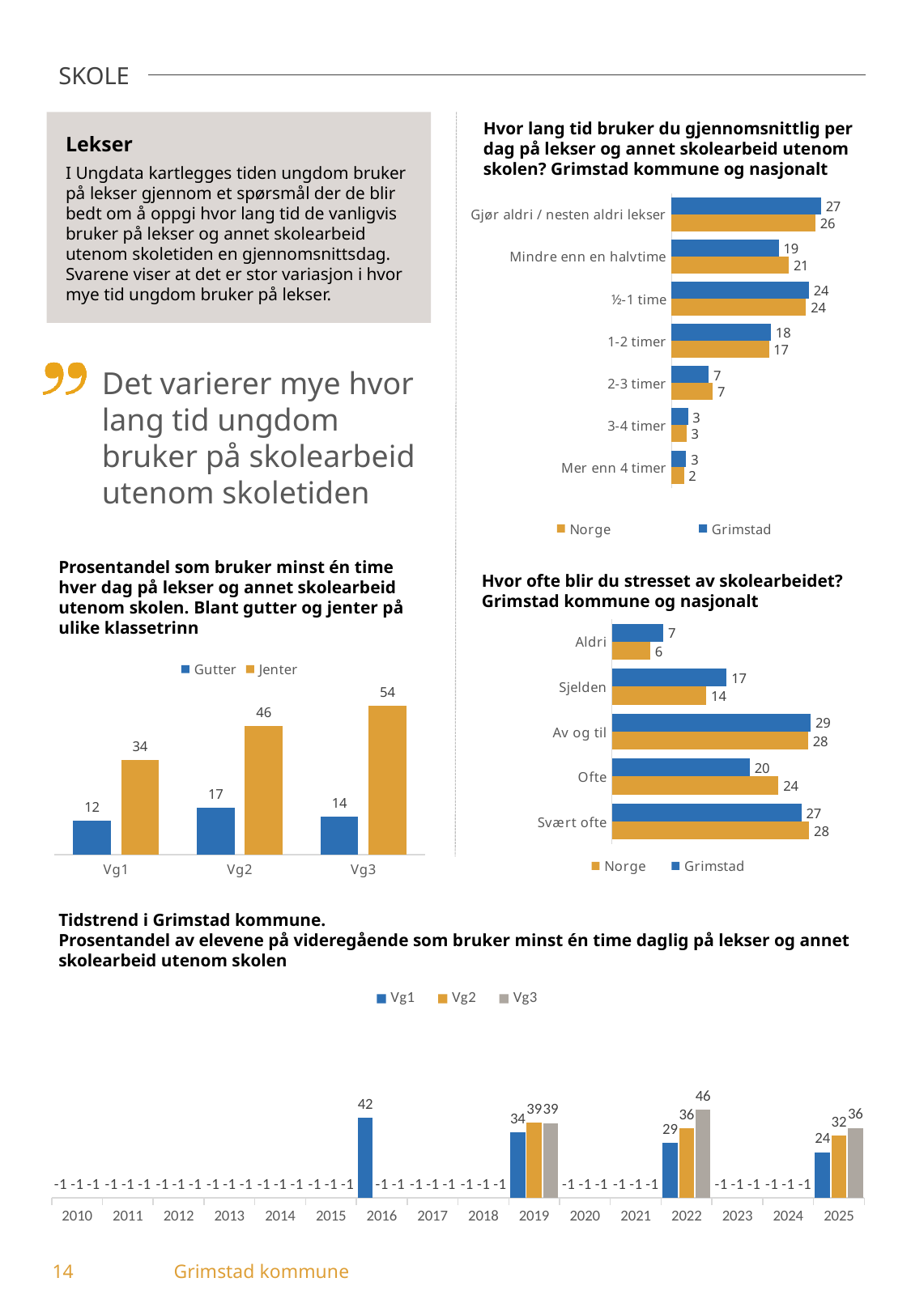
In the chart 'Hvor lang tid bruker du gjennomsnittlig per dag på lekser og annet skolearbeid utenom skolen?', how many categories are shown? 7 In the chart 'Tidstrend i Grimstad kommune', does the Vg1 value rise or fall from 2016 to 2025? fall In the chart 'Prosentandel som bruker minst én time hver dag på lekser og annet skolearbeid utenom skolen', which class level has the lowest value for Gutter? Vg1 In the chart 'Prosentandel som bruker minst én time hver dag på lekser og annet skolearbeid utenom skolen', what is the value for Jenter at Vg3? 54 In the chart 'Hvor ofte blir du stresset av skolearbeidet?', how many series does the legend list? 2 What kind of chart is 'Tidstrend i Grimstad kommune'? bar chart In the chart 'Prosentandel som bruker minst én time hver dag på lekser og annet skolearbeid utenom skolen', what is the difference between Jenter and Gutter at Vg2? 29 In the chart 'Hvor lang tid bruker du gjennomsnittlig per dag på lekser og annet skolearbeid utenom skolen?', what is the Grimstad value for 'Mindre enn en halvtime'? 19 In the chart 'Hvor ofte blir du stresset av skolearbeidet?', what is the Norge value for 'Ofte'? 24 In the chart 'Hvor lang tid bruker du gjennomsnittlig per dag på lekser og annet skolearbeid utenom skolen?', which category has the highest Grimstad value? Gjør aldri / nesten aldri lekser In the chart 'Hvor ofte blir du stresset av skolearbeidet?', which is larger for 'Sjelden': Grimstad or Norge? Grimstad In the chart 'Tidstrend i Grimstad kommune', what is the value for Vg3 in 2022? 46